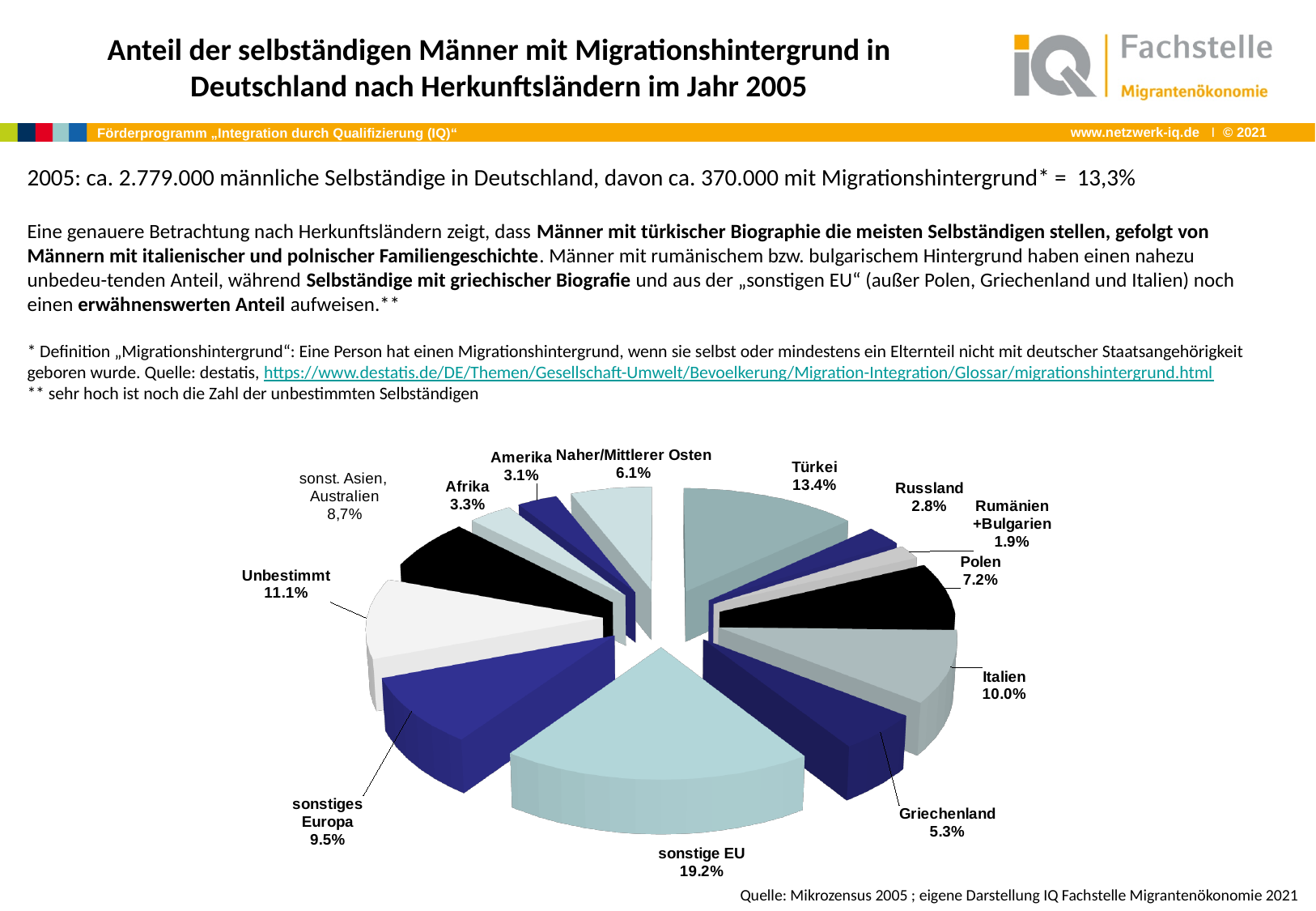
What is the value shown for sonst. Asien, Australien? 8,7% What is the value shown for Griechenland? 5.3% Which is larger, the share for Polen or the share for Griechenland? Polen What is the difference in percentage points between Türkei and Italien? 3.4 Which category has the largest slice of the pie? sonstige EU What is the value shown for Italien? 10.0% Which category has the smallest slice of the pie? Rumänien+Bulgarien What is the value shown for Naher/Mittlerer Osten? 6.1% Which is larger, the share for Unbestimmt or the share for sonstiges Europa? Unbestimmt How many categories (slices) does the pie chart show? 13 What share of the pie does Türkei account for? 13.4% What kind of chart is shown on the slide? Pie chart